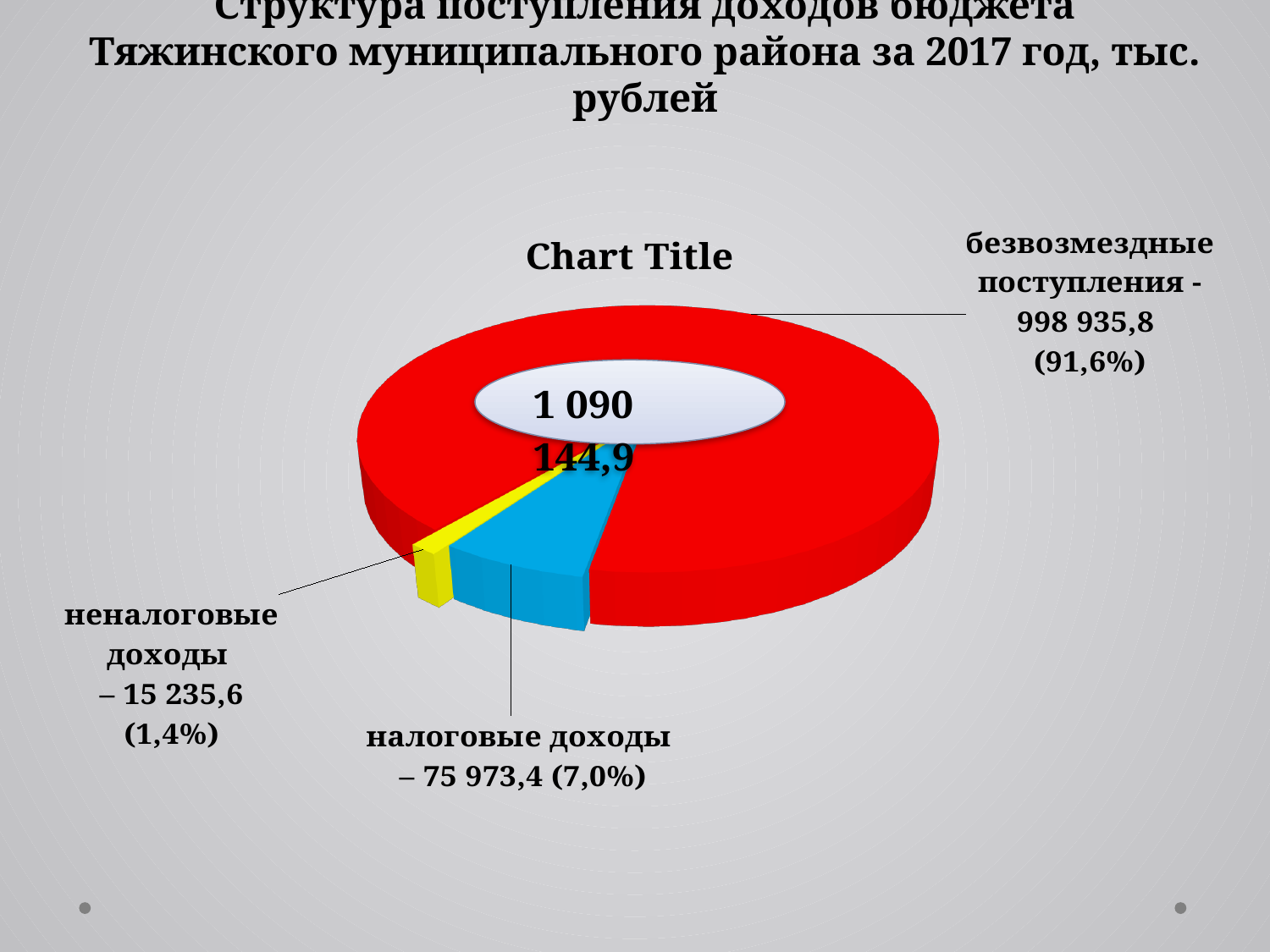
What share of the pie do налоговые доходы make up? 7,0% Which is larger, налоговые доходы or неналоговые доходы? налоговые доходы What is the value for налоговые доходы? 75 973,4 What type of chart is shown on the slide? pie chart Which category has the smallest slice of the pie? неналоговые доходы What total value is shown in the centre of the pie chart? 1 090 144,9 What share of the pie do неналоговые доходы make up? 1,4% What is the value for неналоговые доходы? 15 235,6 Which category has the largest slice of the pie? безвозмездные поступления How many slices does the pie chart have? 3 What is the value for безвозмездные поступления? 998 935,8 What share of the pie do безвозмездные поступления make up? 91,6%